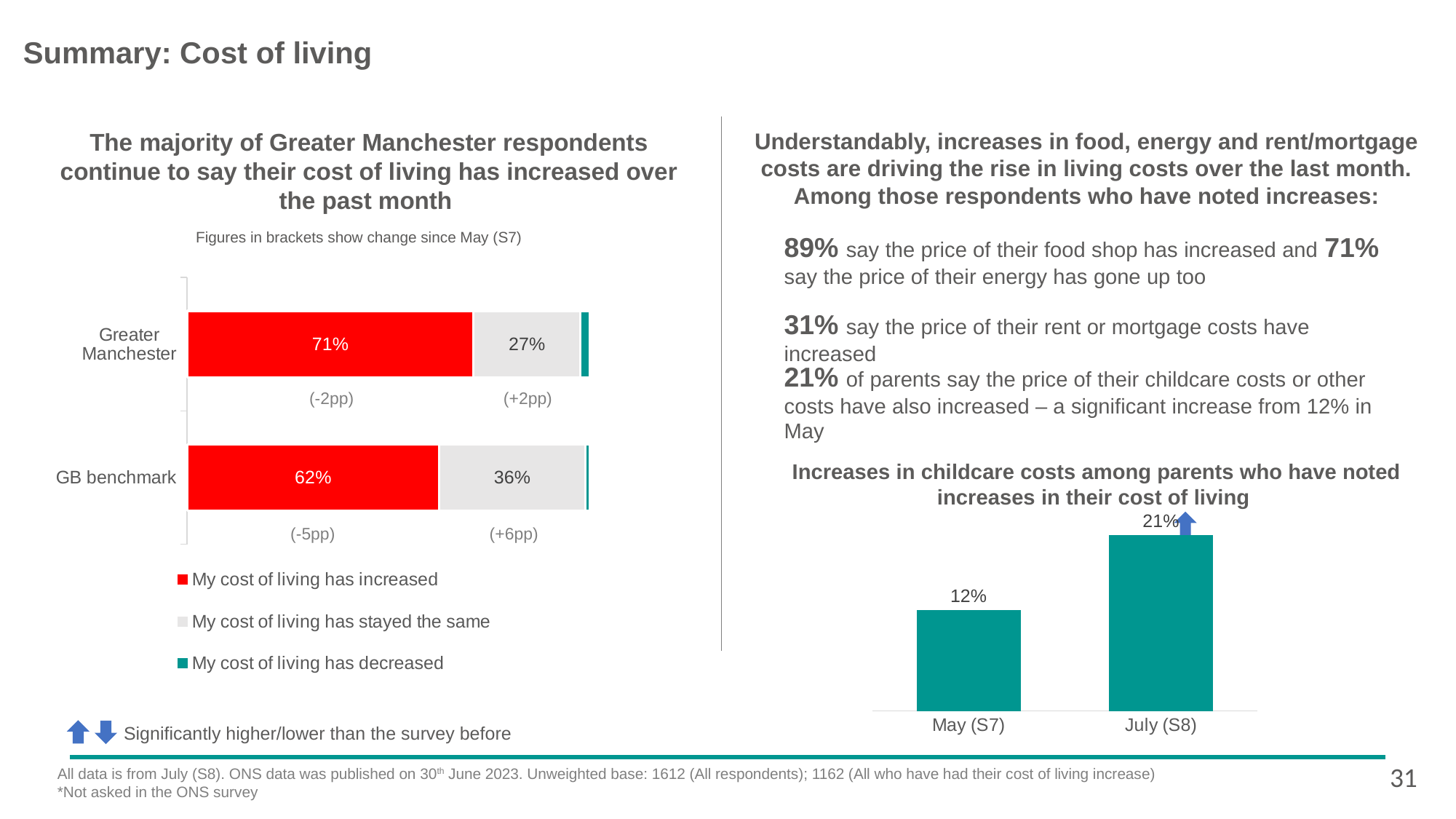
In the left-hand stacked bar chart, which has the larger 'stayed the same' share: Greater Manchester or GB benchmark? GB benchmark In the left-hand stacked bar chart, what percentage of the GB benchmark say their cost of living has stayed the same? 36% In the chart titled 'Increases in childcare costs among parents who have noted increases in their cost of living', do the values rise or fall from May (S7) to July (S8)? Rise In the left-hand stacked bar chart, what change since May is shown in brackets under the GB benchmark 'stayed the same' segment? +6pp In the left-hand stacked bar chart, what change since May is shown in brackets under the Greater Manchester 'increased' segment? -2pp In the chart titled 'Increases in childcare costs among parents who have noted increases in their cost of living', what is the value for July (S8)? 21% In the left-hand stacked bar chart, how many series does the legend list? 3 In the chart titled 'Increases in childcare costs among parents who have noted increases in their cost of living', what is the value for May (S7)? 12% In the left-hand stacked bar chart, what percentage of Greater Manchester respondents say their cost of living has increased? 71% In the chart titled 'Increases in childcare costs among parents who have noted increases in their cost of living', by how many percentage points did the value rise from May (S7) to July (S8)? 9 percentage points What type of chart is the left-hand chart comparing Greater Manchester and the GB benchmark? Stacked bar chart In the left-hand stacked bar chart, what is the difference between the 'increased' share for Greater Manchester and for the GB benchmark? 9 percentage points